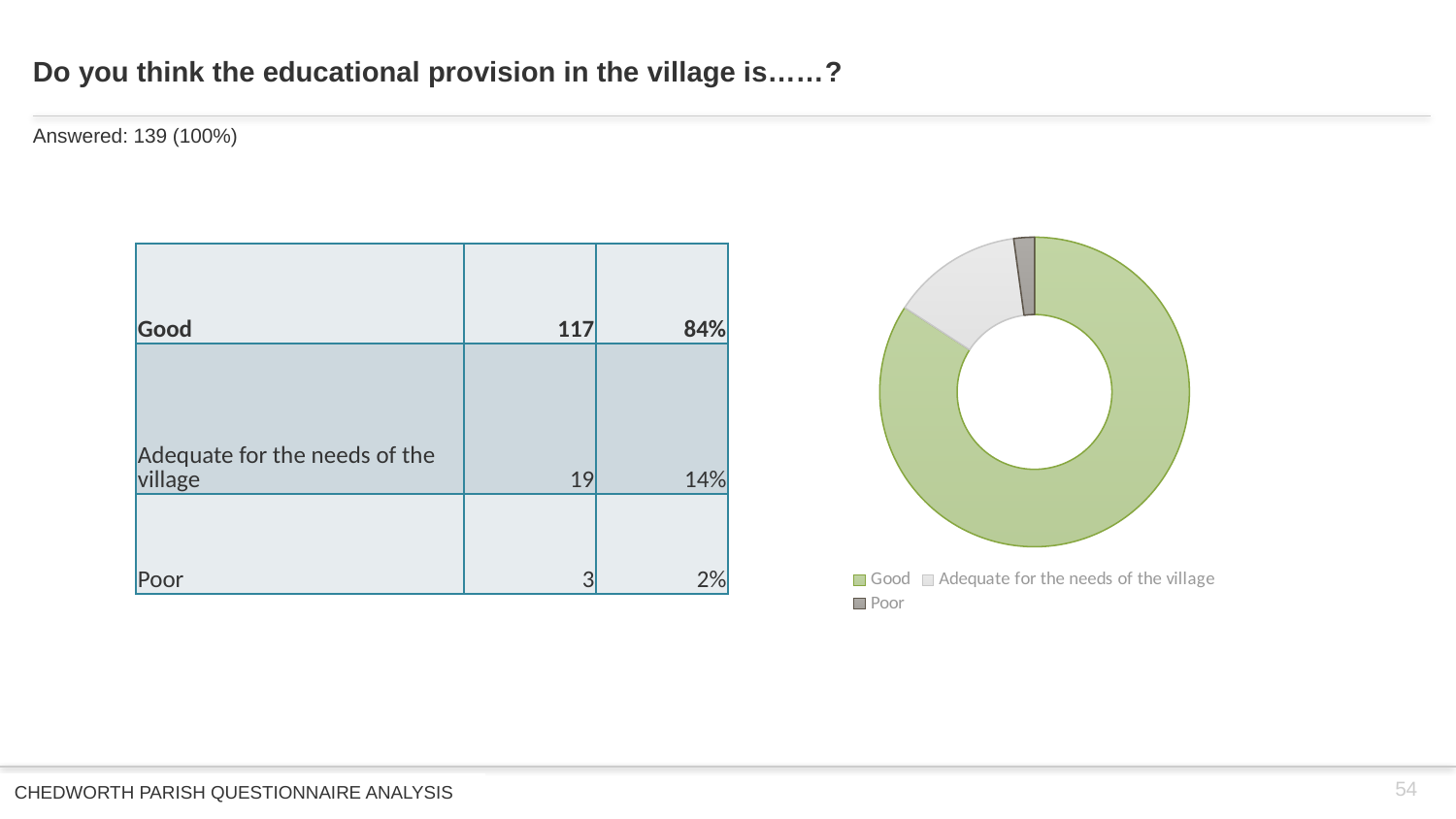
Which category takes up the smallest share of the doughnut chart? Poor Which slice is larger: 'Adequate for the needs of the village' or 'Poor'? Adequate for the needs of the village What colour is the 'Good' slice in the doughnut chart? Green What share of responses does the 'Adequate for the needs of the village' slice represent? 14% What is the difference in number of responses between 'Good' and 'Adequate for the needs of the village'? 98 Which category takes up the largest share of the doughnut chart? Good How many categories does the chart's legend list? 3 What share of responses does the 'Good' slice represent? 84% What kind of chart is shown on the slide? Doughnut chart How many respondents answered 'Poor'? 3 How many respondents answered 'Good'? 117 What share of responses does the 'Poor' slice represent? 2%